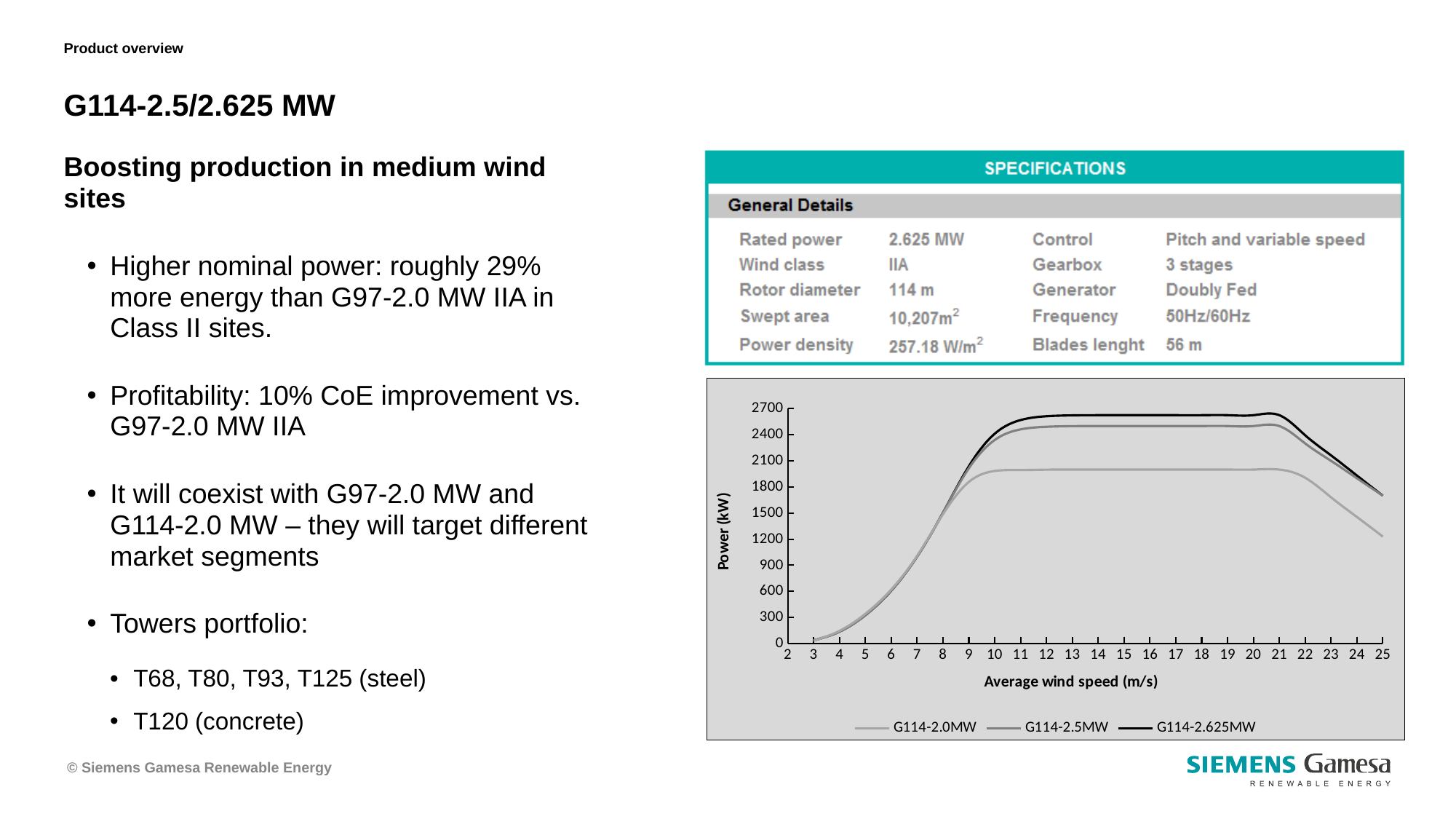
Which series reaches the highest power in the chart? G114-2.625MW What kind of chart is shown on the slide? line chart Is the value for G114-2.0MW at 25 m/s greater or less than 1500? less What is the label of the y axis of the chart? Power (kW) Which series has the lowest power at 15 m/s? G114-2.0MW Do the power values rise or fall as wind speed increases from 21 to 25 m/s? fall Is the value for G114-2.0MW at 15 m/s greater or less than 1800? greater At 15 m/s, which is larger: the power of G114-2.625MW or G114-2.0MW? G114-2.625MW Is the value for G114-2.5MW at 5 m/s greater or less than 600? less How many series does the chart legend list? 3 What is the label of the x axis of the chart? Average wind speed (m/s)